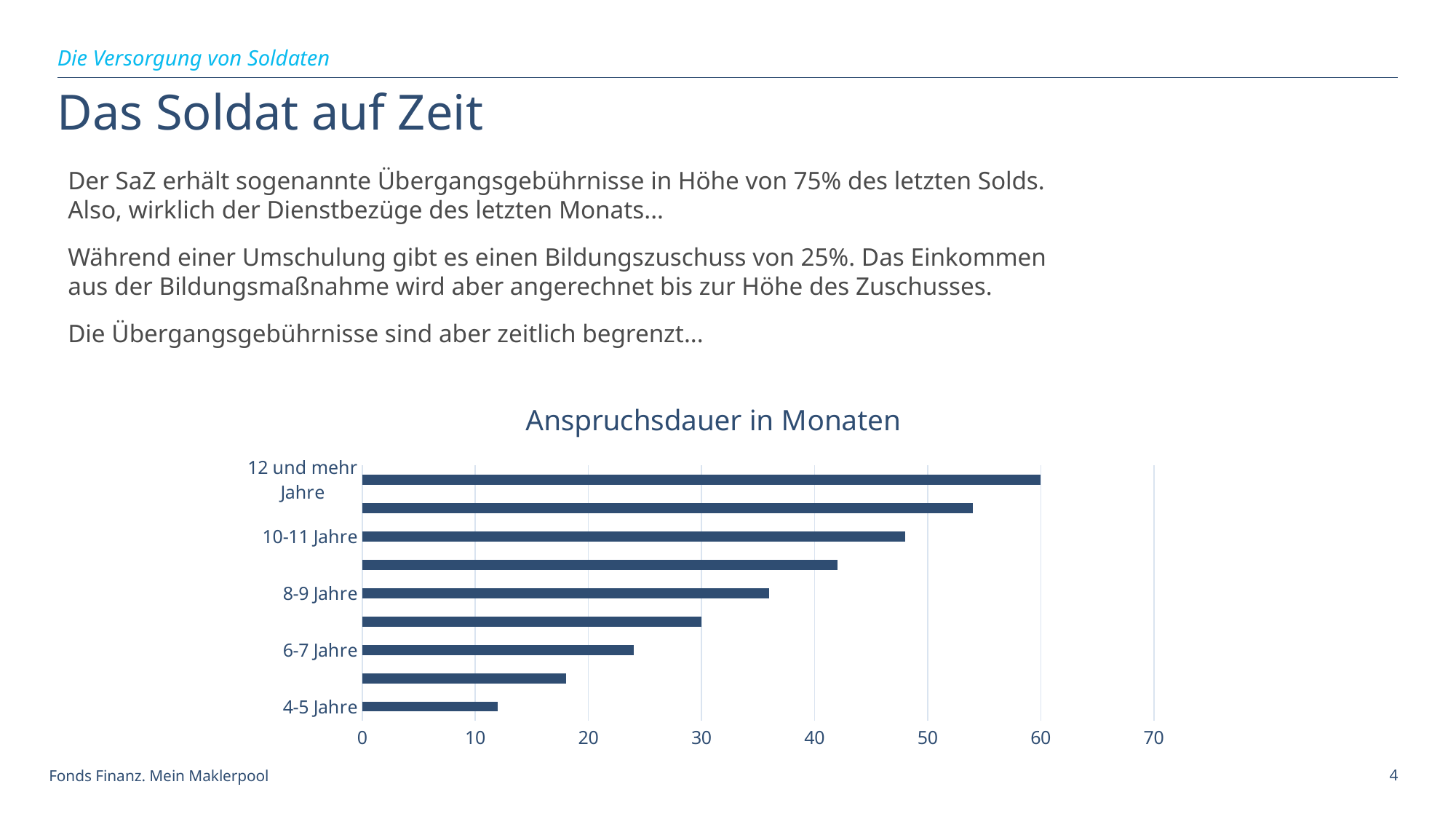
Is the value for 8-9 Jahre greater or less than 40? less Which is larger, the value for 10-11 Jahre or the value for 6-7 Jahre? 10-11 Jahre What is the title of the chart? Anspruchsdauer in Monaten Is the value for 4-5 Jahre greater or less than 10? greater What is the value for 12 und mehr Jahre? 60 What kind of chart is shown on the slide? bar chart Is the value for 6-7 Jahre greater or less than 20? greater Which category has the lowest value in the chart? 4-5 Jahre Which category has the highest value in the chart? 12 und mehr Jahre How many bars are plotted in the chart? 9 Do the values rise or fall as the years of service increase from 4-5 Jahre to 12 und mehr Jahre? rise